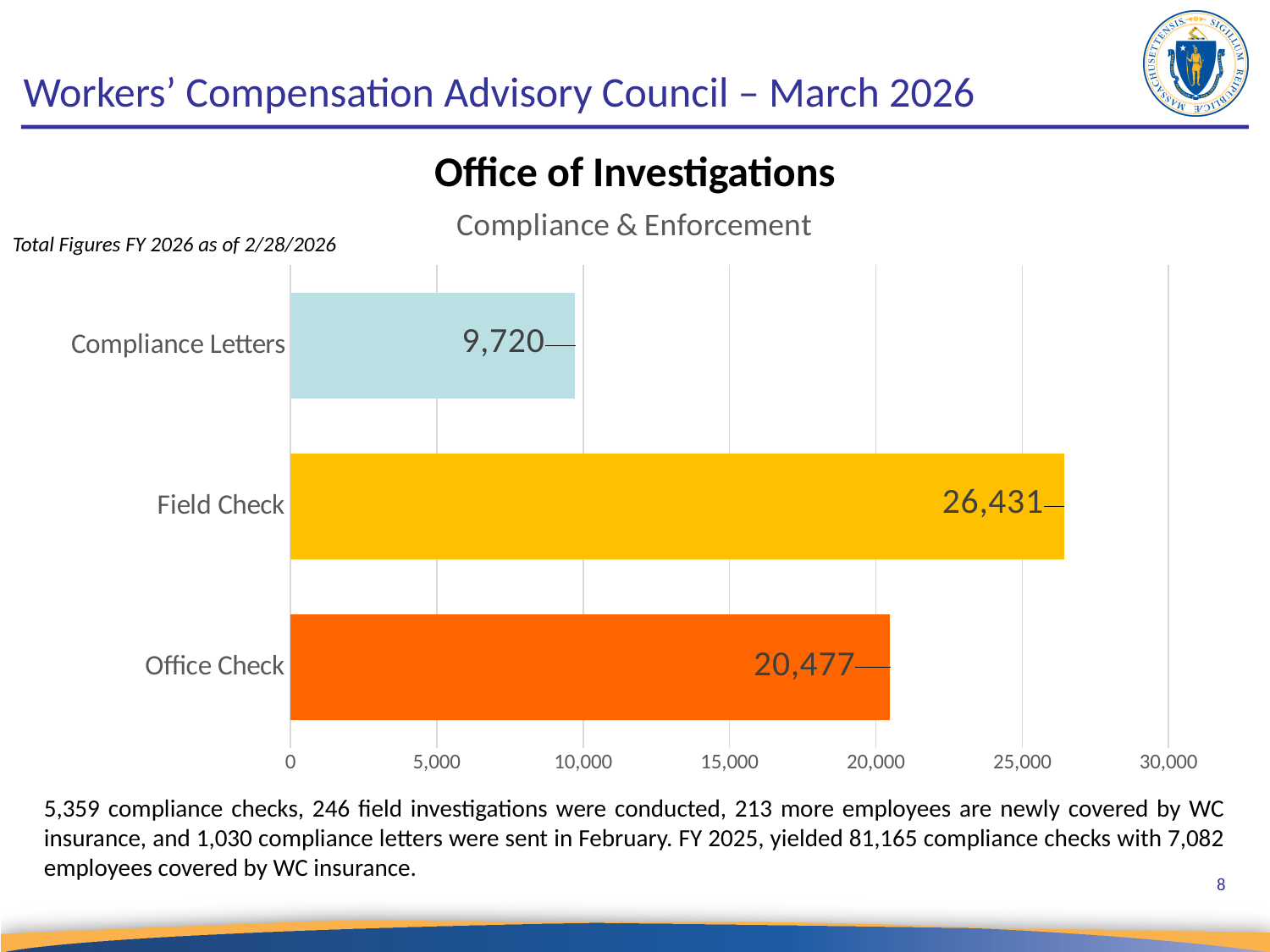
What kind of chart is shown on the slide? bar chart What is the value for Field Check? 26,431 Which category has the lowest value? Compliance Letters What is the title of the chart? Compliance & Enforcement What is the difference between the Office Check and Compliance Letters values? 10,757 What is the difference between the Field Check and Office Check values? 5,954 What is the value for Compliance Letters? 9,720 How many categories are shown in the chart? 3 Which category has the highest value? Field Check Is the value for Field Check greater or less than 25,000? greater Which is larger, Office Check or Compliance Letters? Office Check What is the value for Office Check? 20,477